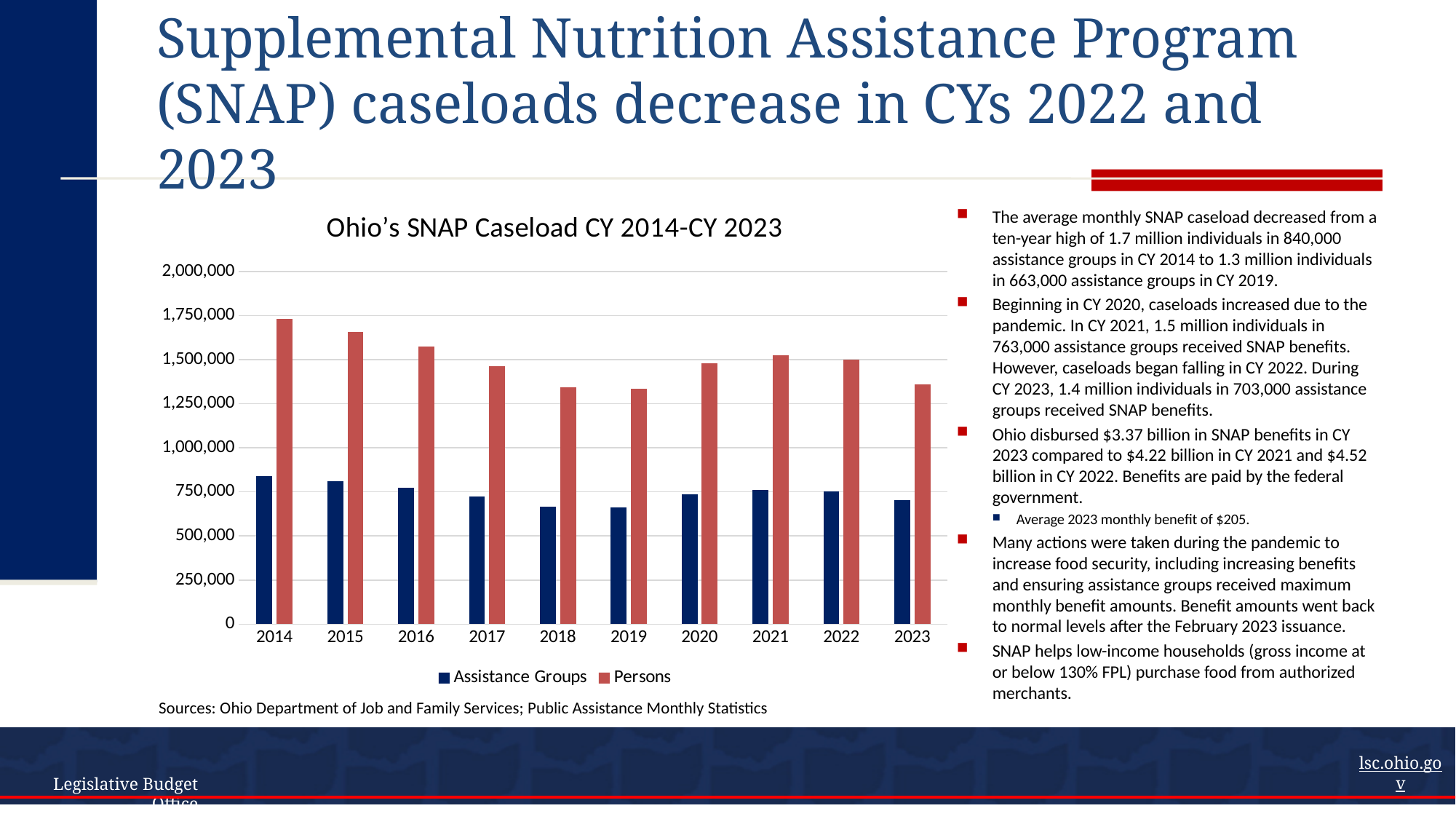
Do the values for Persons rise or fall from 2014 to 2019? fall Is the value for Assistance Groups in 2019 greater or less than 750,000? less Which is larger, the value for Persons in 2014 or in 2023? 2014 Is the value for Persons in 2018 greater or less than 1,500,000? less Which year has the highest value for Persons? 2014 How many years are shown on the x axis of the chart? 10 How many series does the chart's legend list? 2 Is the value for Assistance Groups in 2014 greater or less than 750,000? greater What is the title of the chart? Ohio's SNAP Caseload CY 2014-CY 2023 What kind of chart is shown on the slide? bar chart Which year has the highest value for Assistance Groups? 2014